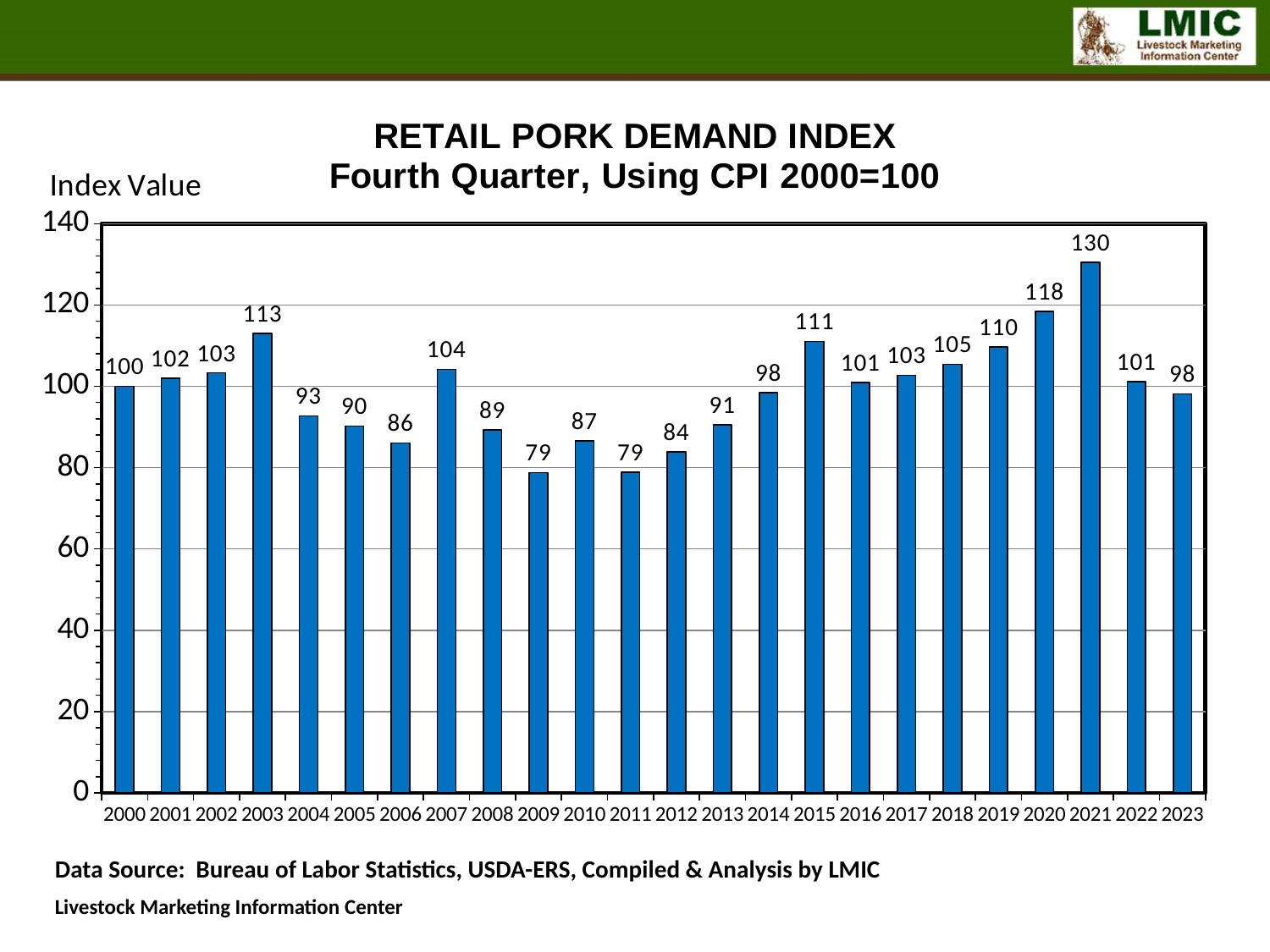
What kind of chart is shown on the slide? Bar chart What is the index value shown for 2023? 98 Do the index values rise or fall from 2011 to 2015? Rise How many years are shown on the x axis? 24 Is the index value for 2020 greater or less than 100? greater What is the difference between the index values for 2021 and 2022? 29 What is the label on the vertical axis of the chart? Index Value What is the lowest index value shown on the chart? 79 What is the index value shown for 2007? 104 What is the Retail Pork Demand Index value for 2021? 130 Which year has a higher index value, 2003 or 2015? 2003 Which year has the highest index value? 2021